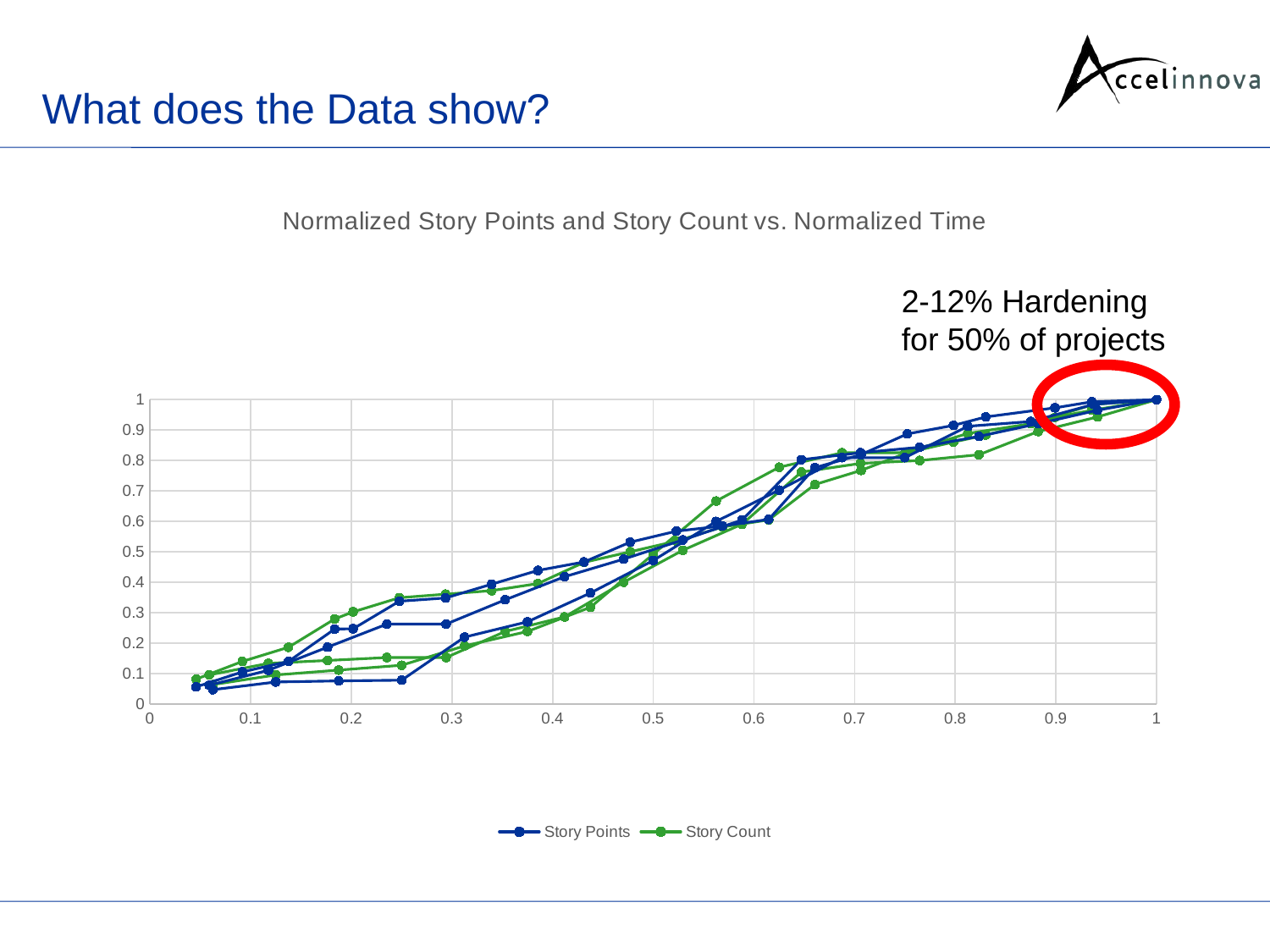
What is the lowest value shown on the y axis of the chart? 0 What is the title of the chart? Normalized Story Points and Story Count vs. Normalized Time At a normalized time of 0.1, are the plotted values greater or less than 0.3? less At a normalized time of 0.9, are the plotted values greater or less than 0.8? greater Do the plotted values rise or fall as normalized time increases from 0 to 1? Rise Which two series are listed in the chart legend? Story Points and Story Count At a normalized time of 0.3, are the plotted values greater or less than 0.5? less What kind of chart is shown on the slide? Line chart What is the highest value shown on the y axis of the chart? 1 What value do all the lines reach at a normalized time of 1? 1 How many series does the chart legend list? 2